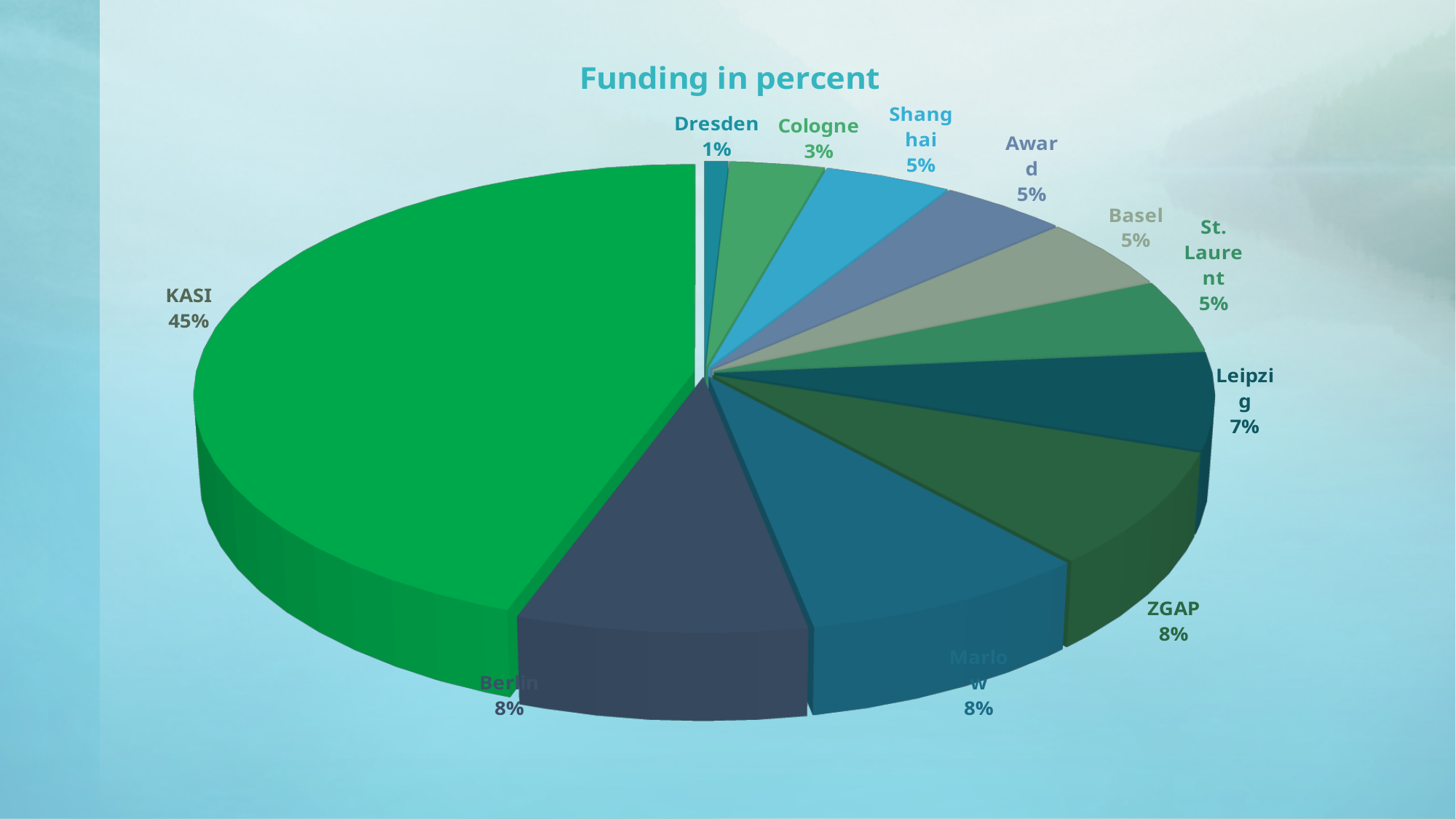
What share of funding does KASI have? 45% What share of funding does ZGAP have? 8% What is the difference in percentage points between KASI and Berlin? 37 What share of funding does Cologne have? 3% What is the title of the chart? Funding in percent What kind of chart is shown on the slide? pie chart Which category has the largest share of funding? KASI How many categories are shown in the pie chart? 11 What share of funding does Dresden have? 1% Which has a larger share of funding, Leipzig or Cologne? Leipzig What share of funding does Leipzig have? 7% Which category has the smallest share of funding? Dresden